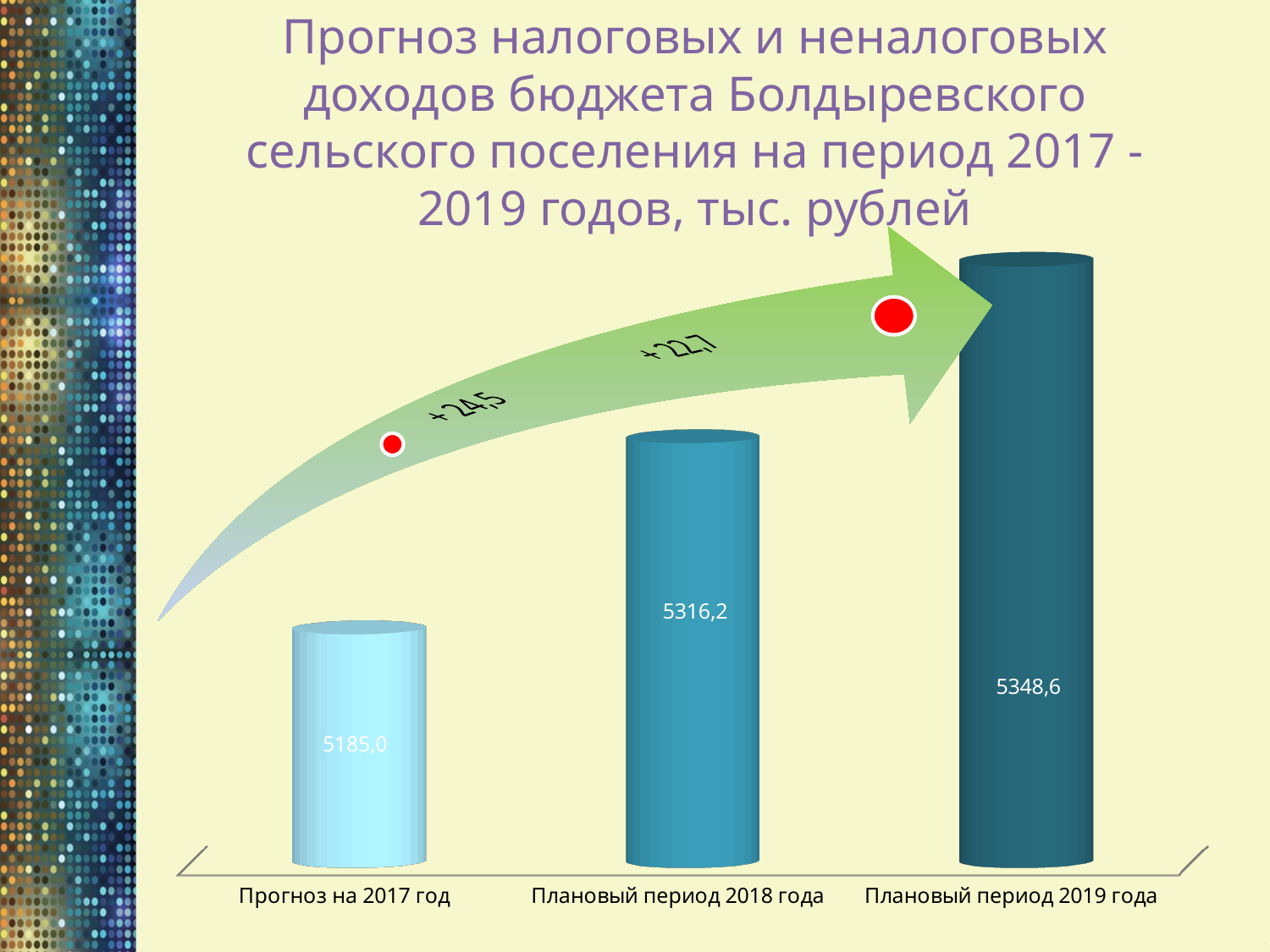
Which category has the lowest value? Прогноз на 2017 год Do the values rise or fall from Прогноз на 2017 год to Плановый период 2019 года? Rise Which is larger, the value for Прогноз на 2017 год or the value for Плановый период 2018 года? Плановый период 2018 года What kind of chart is shown on the slide? Bar chart How many categories are shown on the chart? 3 What is the value for Плановый период 2019 года? 5348,6 What is the difference between the values for Плановый период 2019 года and Прогноз на 2017 год? 163,6 What is the difference between the values for Плановый период 2018 года and Прогноз на 2017 год? 131,2 What is the value for Плановый период 2018 года? 5316,2 Which category has the highest value? Плановый период 2019 года What is the difference between the values for Плановый период 2019 года and Плановый период 2018 года? 32,4 What is the value for Прогноз на 2017 год? 5185,0